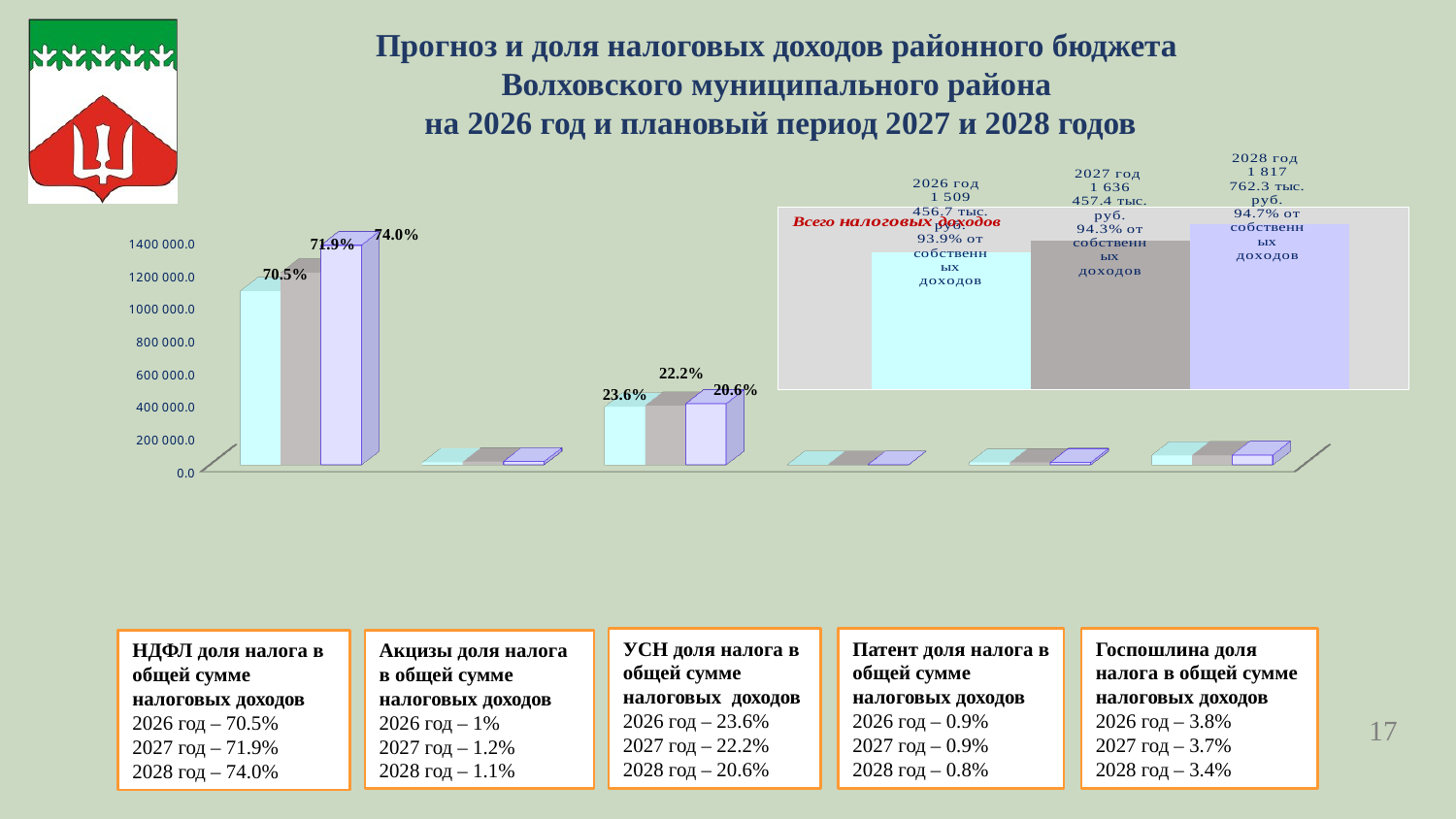
Do the percentage labels in the leftmost group of bars rise or fall from 2026 to 2028? rise What percentage label is shown on the 2028 bar in the third group of bars (УСН)? 20.6% What percentage label is shown on the 2028 bar in the leftmost group of bars? 74.0% Which group of bars has the tallest bars on the chart? the leftmost group (НДФЛ) By how many percentage points does the 2028 label in the leftmost group exceed the 2026 label in that group? 3.5 percentage points What percentage label is shown on the 2026 bar in the leftmost group of bars? 70.5% Do the percentage labels in the third group of bars (УСН) rise or fall from 2026 to 2028? fall Is the 2026 bar in the leftmost group greater or less than 1 000 000.0 on the vertical axis? greater By how many percentage points does the 2026 label in the third group (УСН) exceed the 2028 label in that group? 3.0 percentage points What kind of chart is shown on the slide? bar chart What percentage label is shown on the 2026 bar in the third group of bars (УСН)? 23.6% How many groups of bars are plotted on the chart? 6